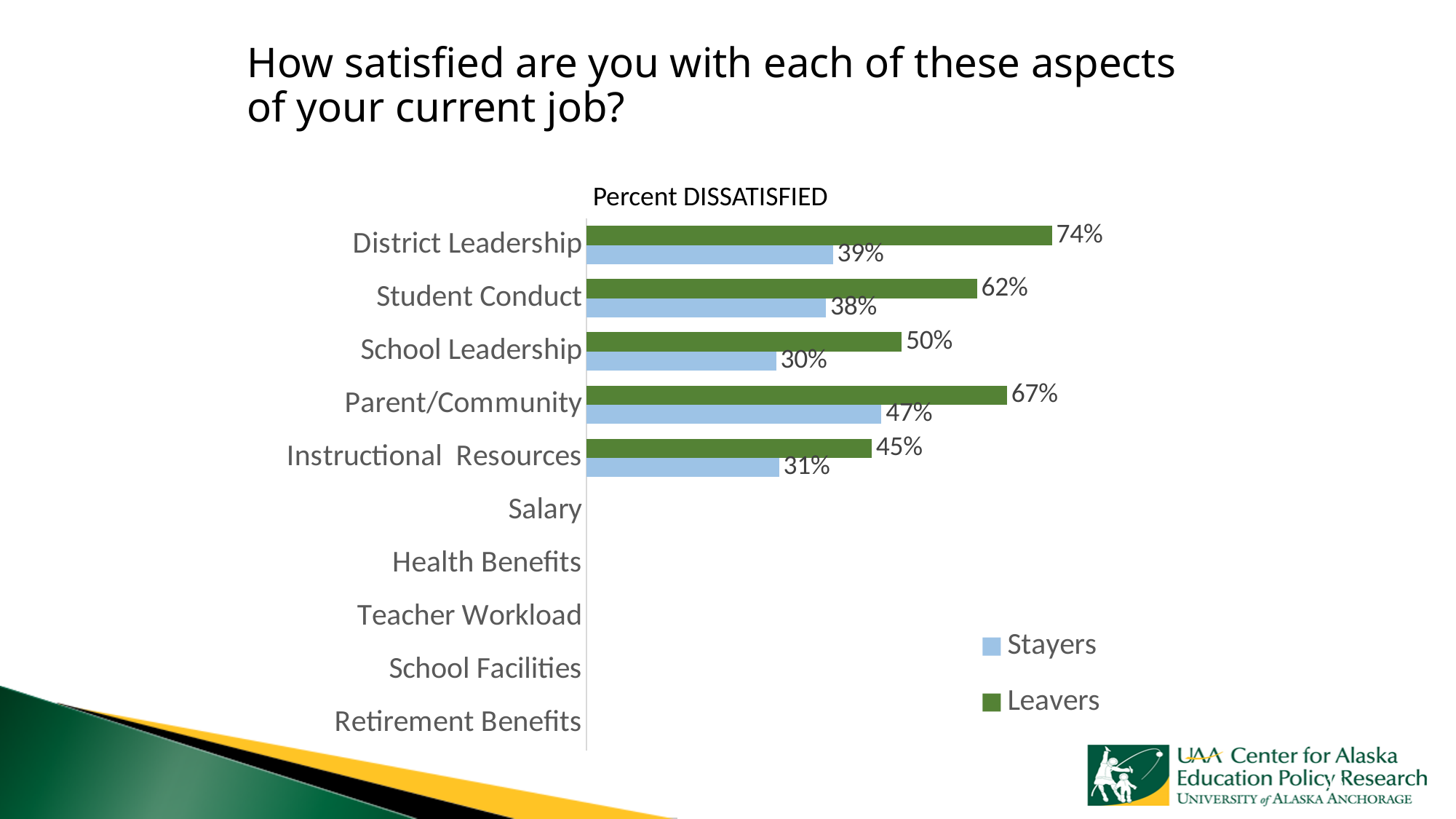
What is the Leavers value for Instructional Resources? 45% Which category has the highest Stayers value? Parent/Community What percent of Leavers are dissatisfied with District Leadership? 74% What percent of Stayers are dissatisfied with Parent/Community? 47% What kind of chart is shown on the slide? Bar chart What is the Stayers value for School Leadership? 30% What is the difference between the Leavers and Stayers values for District Leadership? 35% Among the categories with bars shown, which has the lowest Leavers value? Instructional Resources How many series does the legend list? 2 Which category has the highest Leavers value? District Leadership Which is larger: the Leavers value for Student Conduct or the Leavers value for Parent/Community? Parent/Community What colour represents the Leavers series? Green